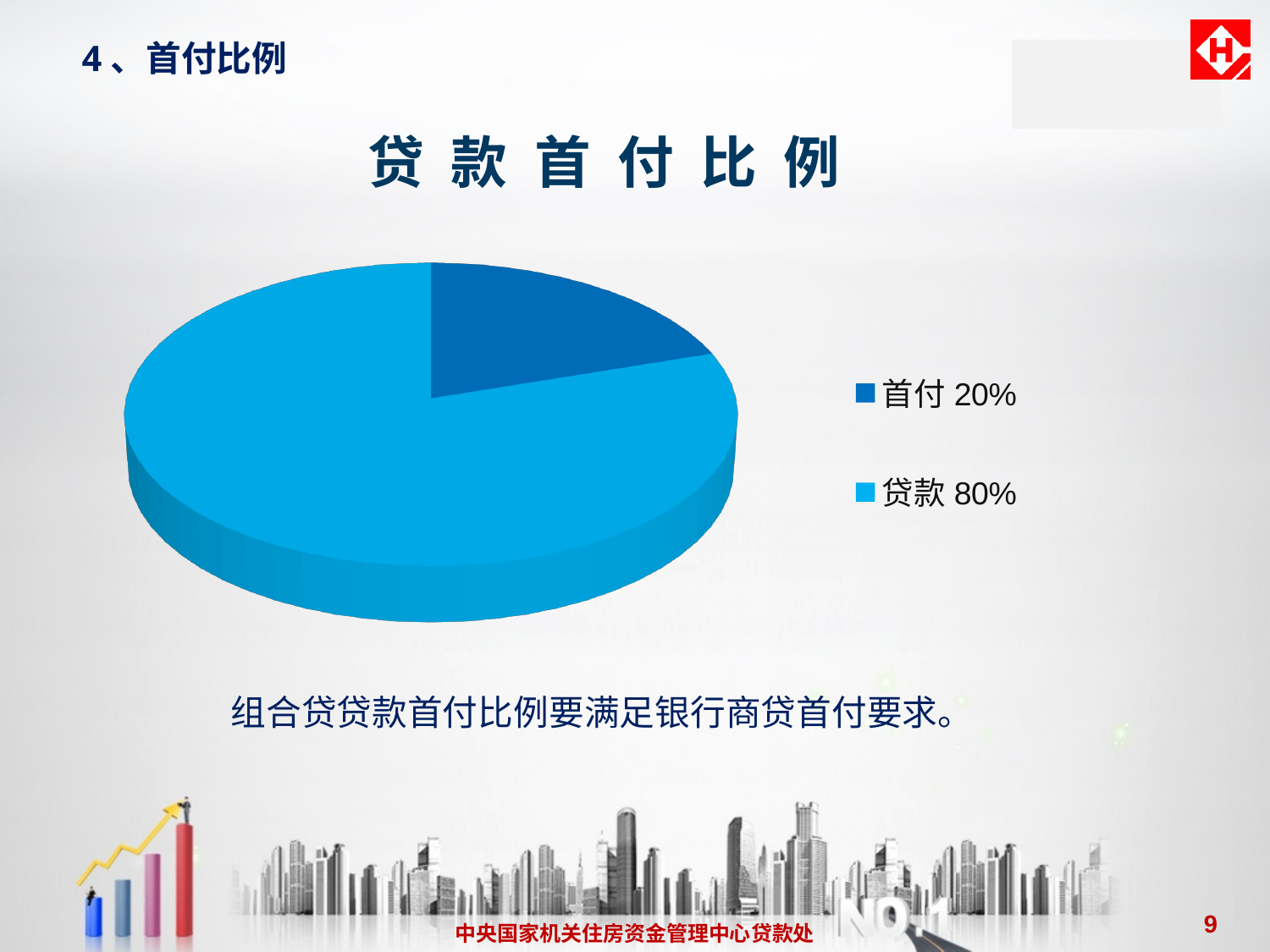
Which legend entry is shown in the darker blue colour? 首付 20% How many slices does the pie chart have? 2 What kind of chart is shown on the slide? pie chart Which is larger, the 首付 slice or the 贷款 slice? 贷款 What is the difference in percentage points between the 贷款 slice and the 首付 slice? 60% What share of the pie does 贷款 represent? 80% How many entries does the legend list? 2 What share of the pie does 首付 represent? 20% Which slice of the pie is the smallest? 首付 Is the share for 首付 greater or less than 50%? less Which slice of the pie is the largest? 贷款 What is the title of the chart? 贷款首付比例